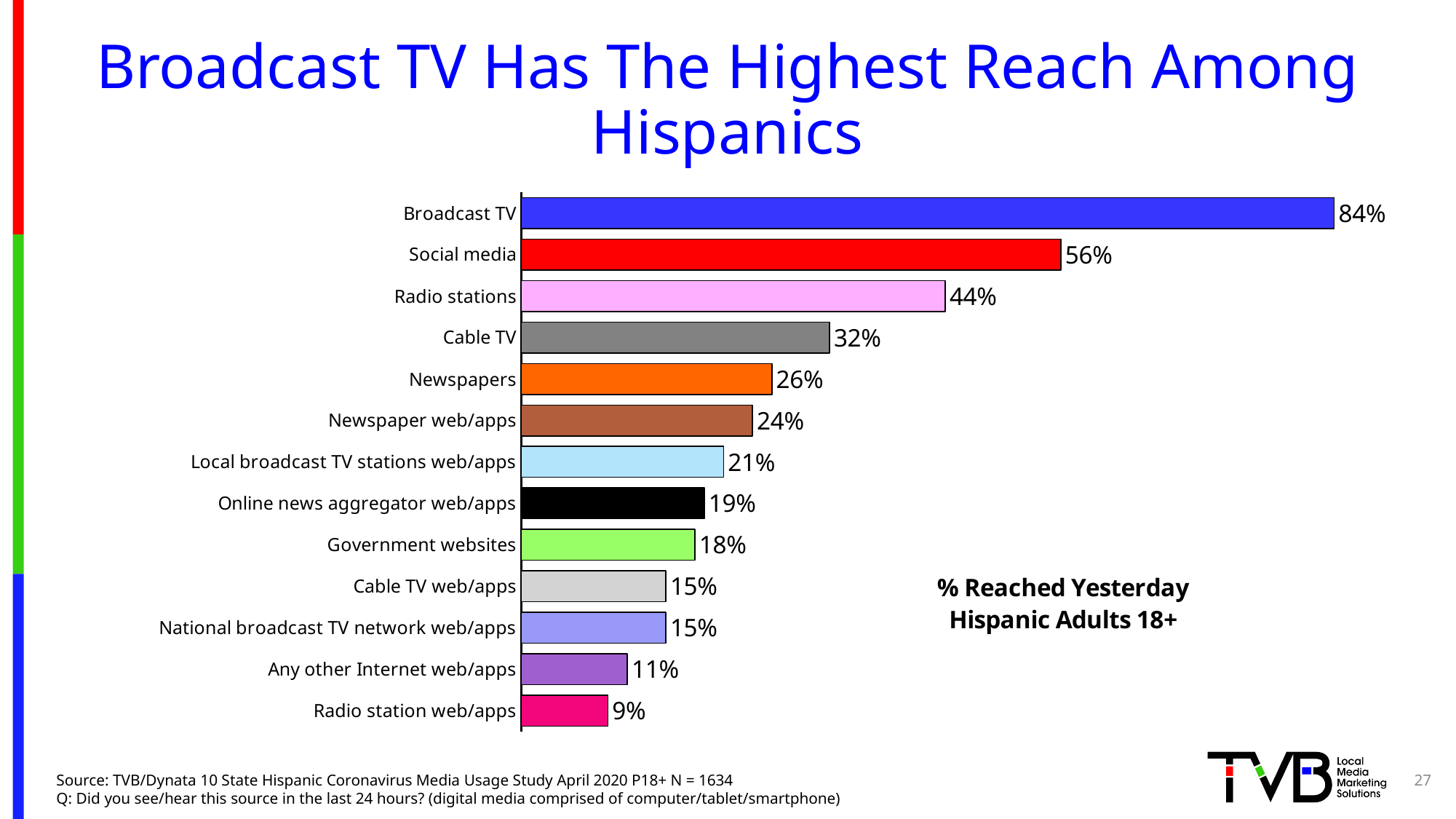
Which category has the lowest value on the chart? Radio station web/apps How many categories are shown on the chart? 13 What is the difference between the values for Broadcast TV and Cable TV? 52 percentage points What is the value shown for Local broadcast TV stations web/apps? 21% What is the value shown for Social media? 56% What kind of chart is shown on the slide? Bar chart Which category has the highest value on the chart? Broadcast TV What colour is the bar for Government websites? Green What is the difference between the values for Newspapers and Newspaper web/apps? 2 percentage points Which is larger, the value for Radio stations or the value for Cable TV? Radio stations Do the values rise or fall going from the top bar to the bottom bar? Fall What percentage of Hispanic adults 18+ were reached yesterday by Broadcast TV? 84%